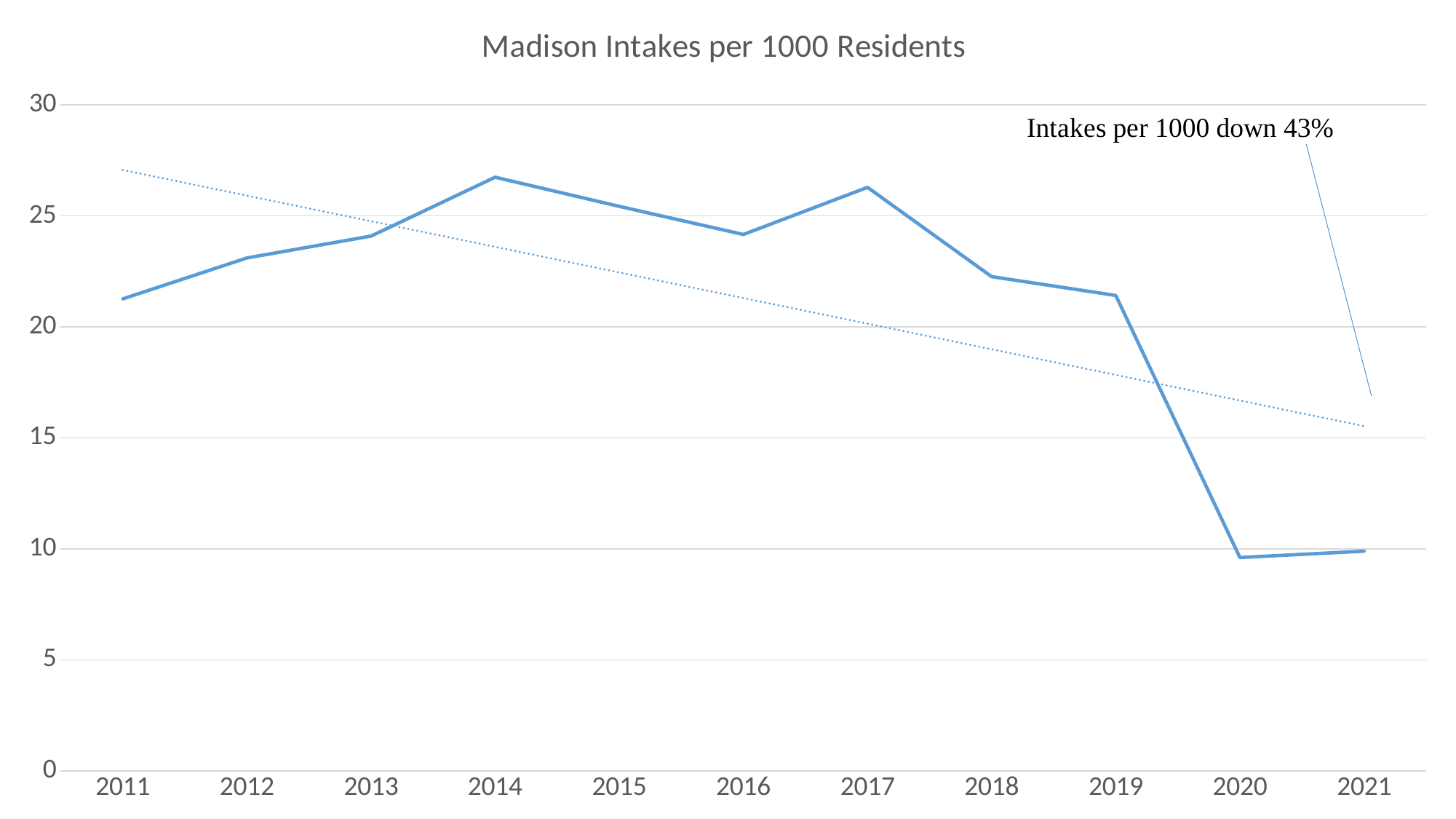
What kind of chart is shown on the slide? line chart Which year has the larger value, 2019 or 2020? 2019 Is the value for 2014 greater or less than 25? greater Is the value for 2011 greater or less than 20? greater What does the text annotation on the chart say? Intakes per 1000 down 43% Is the value for 2020 greater or less than 10? less Which year has the larger value, 2014 or 2016? 2014 How many years are plotted along the x axis? 11 Overall, do the values rise or fall from 2011 to 2021? fall What is the title of the chart? Madison Intakes per 1000 Residents